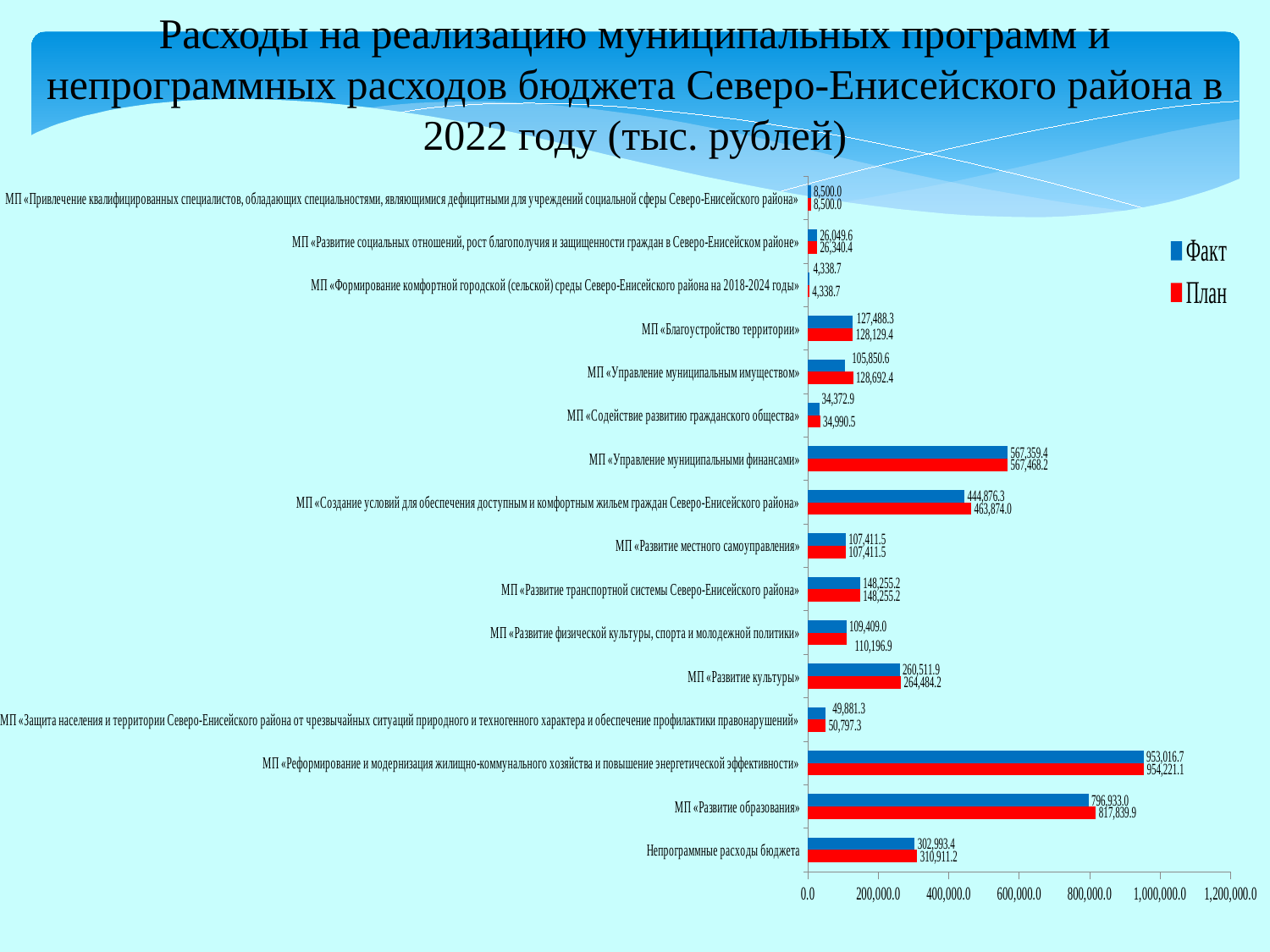
Which colour represents the Факт series in the legend? blue How many categories are plotted on the chart? 16 What is the План value for МП «Управление муниципальным имуществом»? 128,692.4 Which category has the highest Факт value? МП «Реформирование и модернизация жилищно-коммунального хозяйства и повышение энергетической эффективности» What type of chart is shown on the slide? bar chart What is the Факт value for МП «Развитие образования»? 796,933.0 Which category has the lowest План value? МП «Формирование комфортной городской (сельской) среды Северо-Енисейского района на 2018-2024 годы» Which is larger for МП «Управление муниципальным имуществом»: the Факт value or the План value? План What is the difference between the План and Факт values for МП «Развитие образования»? 20,906.9 What is the difference between the План and Факт values for МП «Развитие культуры»? 3,972.3 How many series does the legend list? 2 What is the Факт value for Непрограммные расходы бюджета? 302,993.4